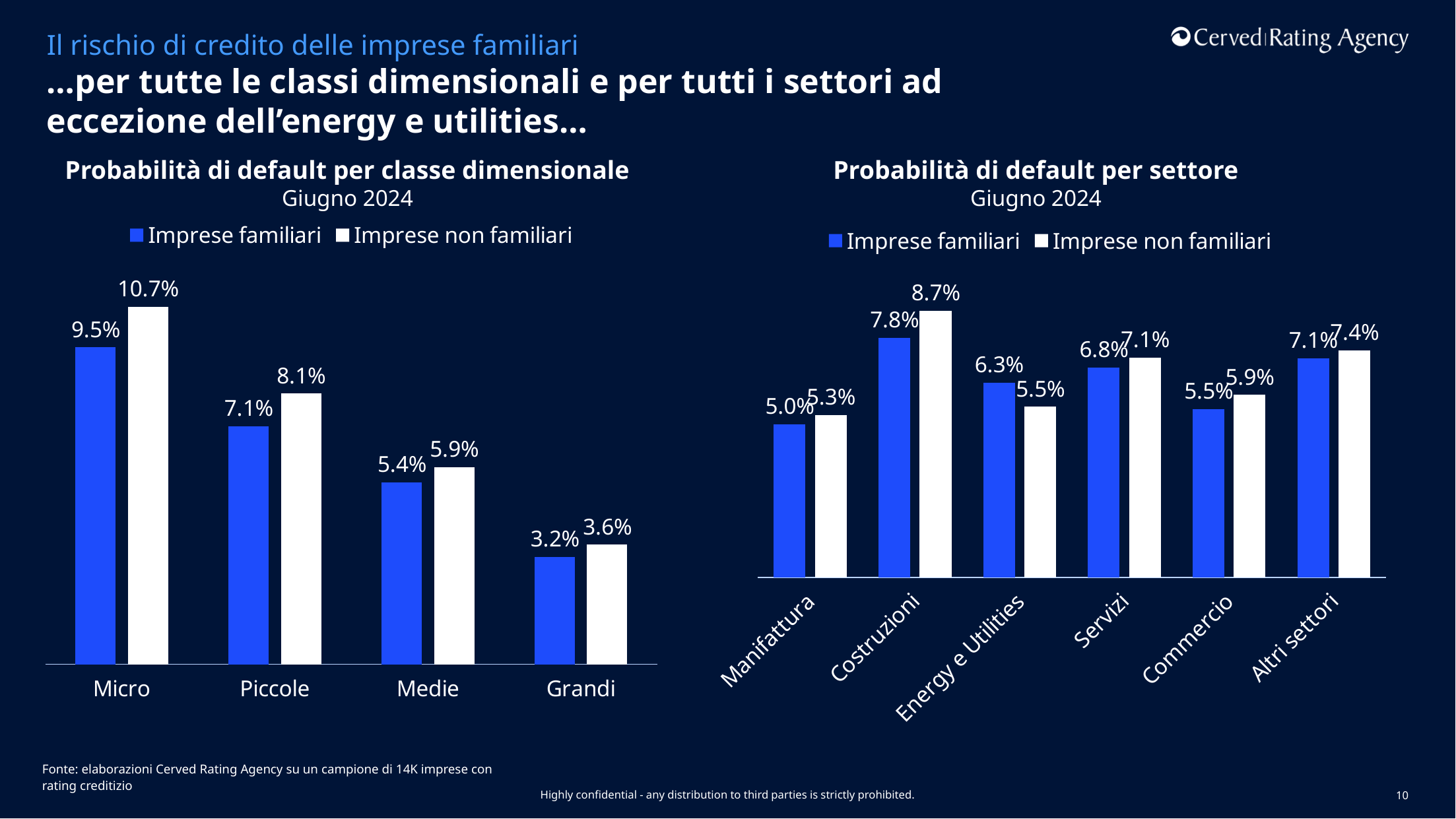
In the 'Probabilità di default per settore' chart, which is larger in Energy e Utilities: Imprese familiari or Imprese non familiari? Imprese familiari In the 'Probabilità di default per classe dimensionale' chart, how many size classes are shown on the x axis? 4 In the 'Probabilità di default per classe dimensionale' chart, which size class has the highest value for Imprese non familiari? Micro In the 'Probabilità di default per settore' chart, which sector has the highest value for Imprese non familiari? Costruzioni In the 'Probabilità di default per settore' chart, what is the value for Imprese familiari in Costruzioni? 7.8% In the 'Probabilità di default per classe dimensionale' chart, what is the value for Imprese familiari in the Micro class? 9.5% In the 'Probabilità di default per classe dimensionale' chart, what is the difference between Imprese non familiari and Imprese familiari in the Micro class? 1.2% In the 'Probabilità di default per classe dimensionale' chart, do the values for Imprese familiari rise or fall from Micro to Grandi? fall In the 'Probabilità di default per settore' chart, what is the value for Imprese non familiari in Energy e Utilities? 5.5% In the 'Probabilità di default per classe dimensionale' chart, which size class has the lowest value for Imprese familiari? Grandi In the 'Probabilità di default per classe dimensionale' chart, what is the value for Imprese non familiari in the Piccole class? 8.1% How many series does the legend of the 'Probabilità di default per settore' chart list? 2